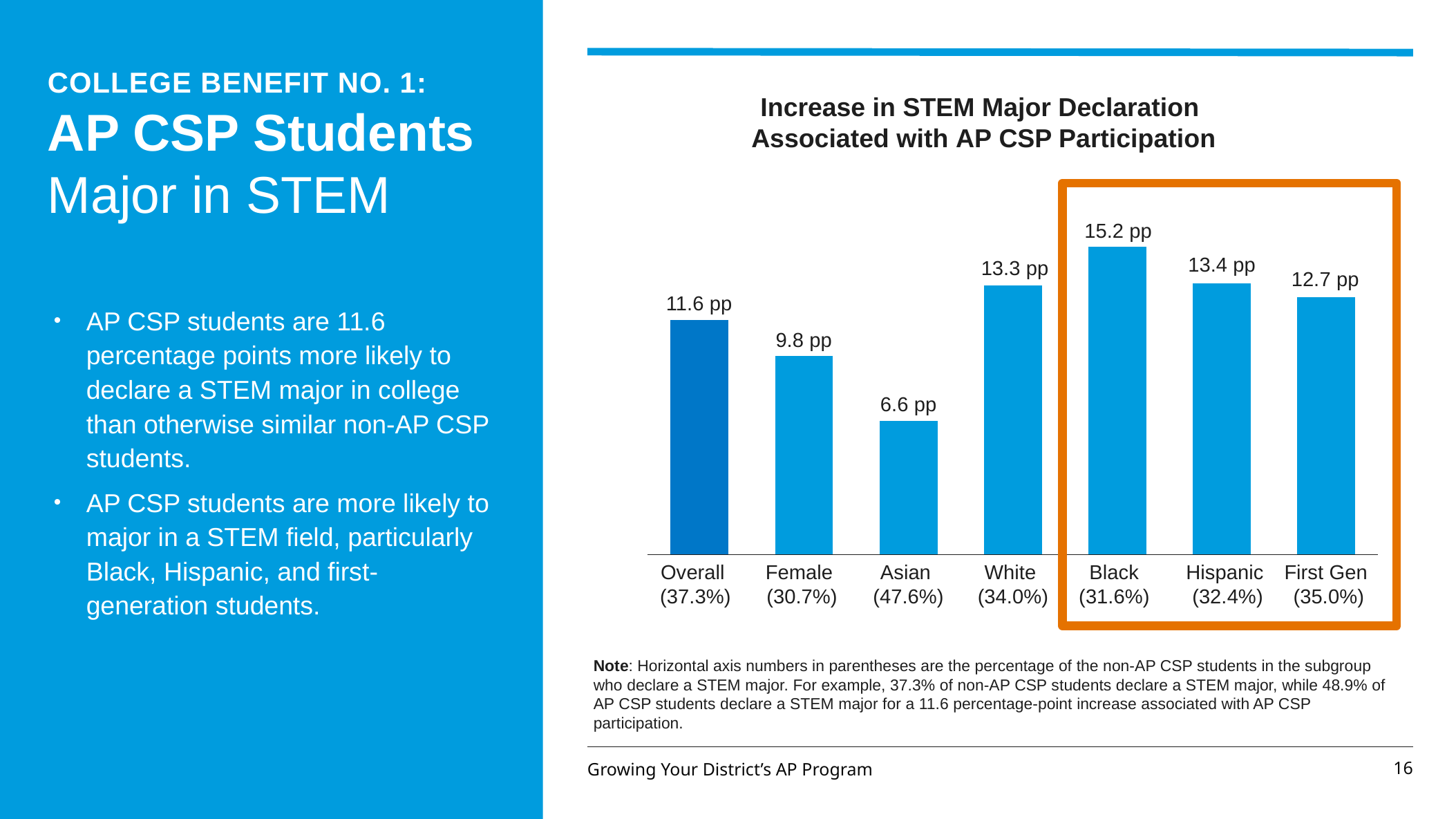
What is the difference between the values for White and Asian? 6.7 pp What is the value for Female in the chart? 9.8 pp What is the value for Asian in the chart? 6.6 pp What kind of chart is shown on the slide? Bar chart What is the difference between the values for Black and Overall? 3.6 pp Which category has the lowest value in the chart? Asian What is the title of the chart? Increase in STEM Major Declaration Associated with AP CSP Participation What is the value for First Gen in the chart? 12.7 pp Which category has the highest value in the chart? Black What is the value for Black in the chart? 15.2 pp Which is larger, the value for Hispanic or the value for Female? Hispanic How many categories are shown in the chart? 7